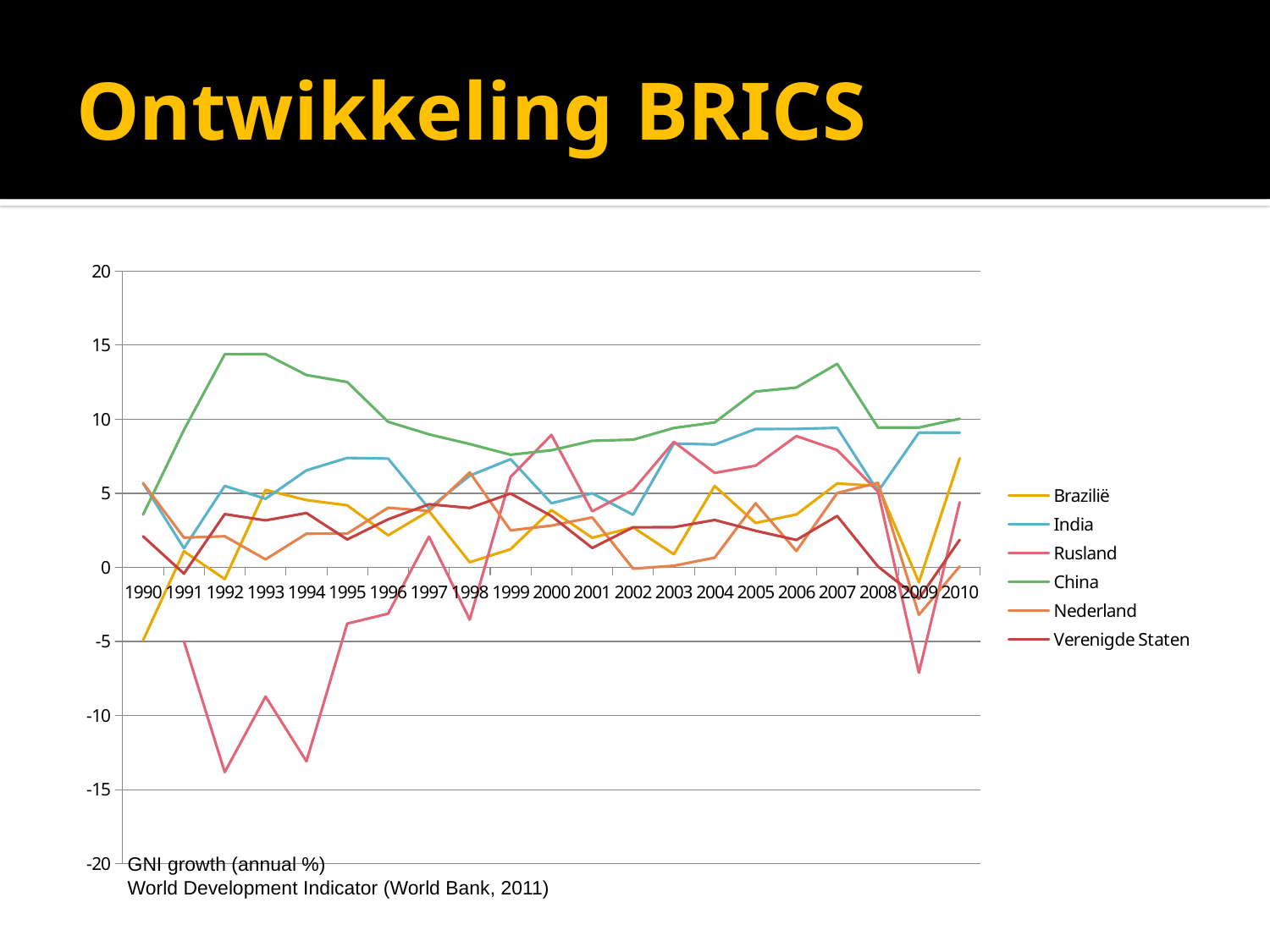
Which series has the lowest value in 1994? Rusland How many series does the legend list? 6 Is the value for China in 1992 greater or less than 10? greater Which series has the highest value in 1993? China What kind of chart is shown on the slide? line chart What is the title of the slide containing the chart? Ontwikkeling BRICS Does the value for China rise or fall from 1993 to 1998? fall Is the value for Rusland in 2009 greater or less than -5? less How many years are plotted along the x axis? 21 Which is larger in 2007, the value for China or the value for India? China Is the value for Brazilië in 1990 greater or less than 0? less